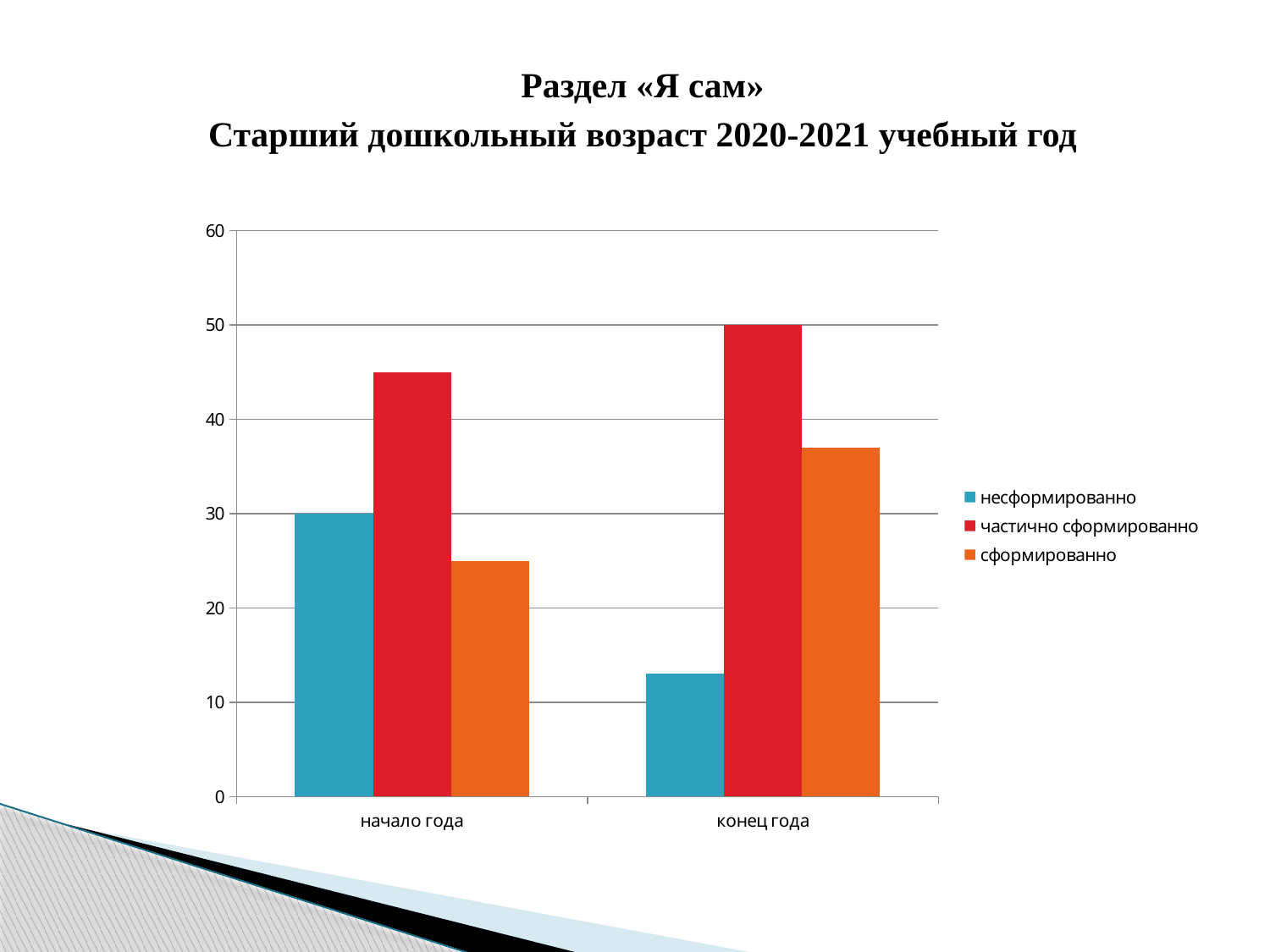
Is the value for несформированно at конец года greater or less than 20? less How many series does the legend list? 3 Is the value for сформированно at начало года greater or less than 30? less What type of chart is shown on the slide? bar chart Does the value for несформированно rise or fall from начало года to конец года? fall What is the value for несформированно at начало года? 30 How many categories are shown on the x axis? 2 Is the value for сформированно at конец года greater or less than 30? greater Which series has the lowest value at конец года? несформированно Which series has the highest value at конец года? частично сформированно What is the value for частично сформированно at конец года? 50